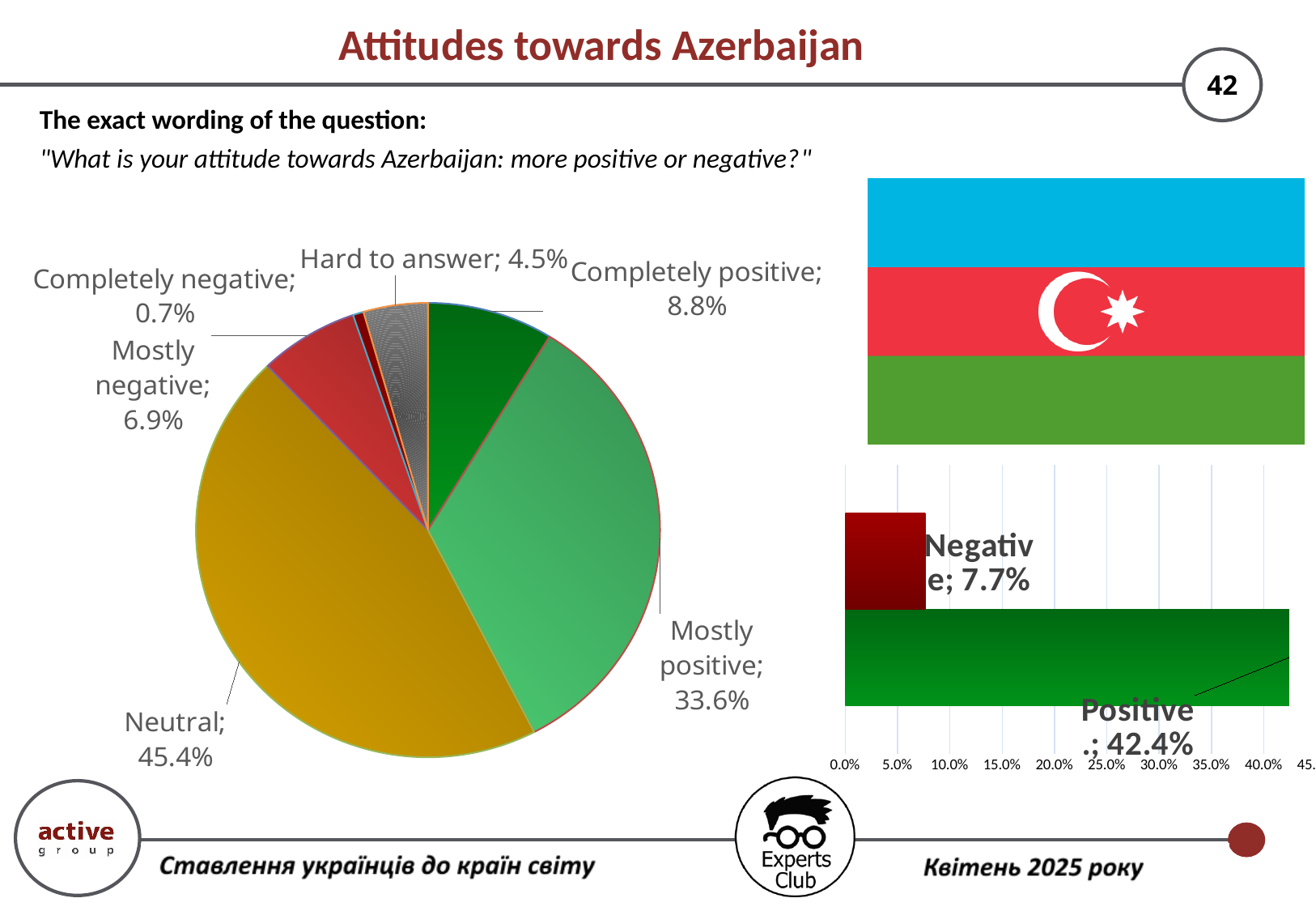
In the pie chart on the left, what is the value for "Mostly positive"? 33.6% In the pie chart on the left, what share of respondents answered "Neutral"? 45.4% In the pie chart on the left, what is the value for "Hard to answer"? 4.5% In the pie chart on the left, which category has the smallest slice? Completely negative In the bar chart on the right, what is the value for "Positive"? 42.4% What type of chart is shown on the left side of the slide? Pie chart In the bar chart on the right, what is the value for "Negative"? 7.7% In the pie chart on the left, what is the difference between "Mostly positive" and "Completely positive"? 24.8% In the bar chart on the right, what is the difference between "Positive" and "Negative"? 34.7% In the pie chart on the left, how many categories are shown? 6 In the pie chart on the left, which is larger: "Mostly negative" or "Hard to answer"? Mostly negative In the pie chart on the left, which category has the largest slice? Neutral